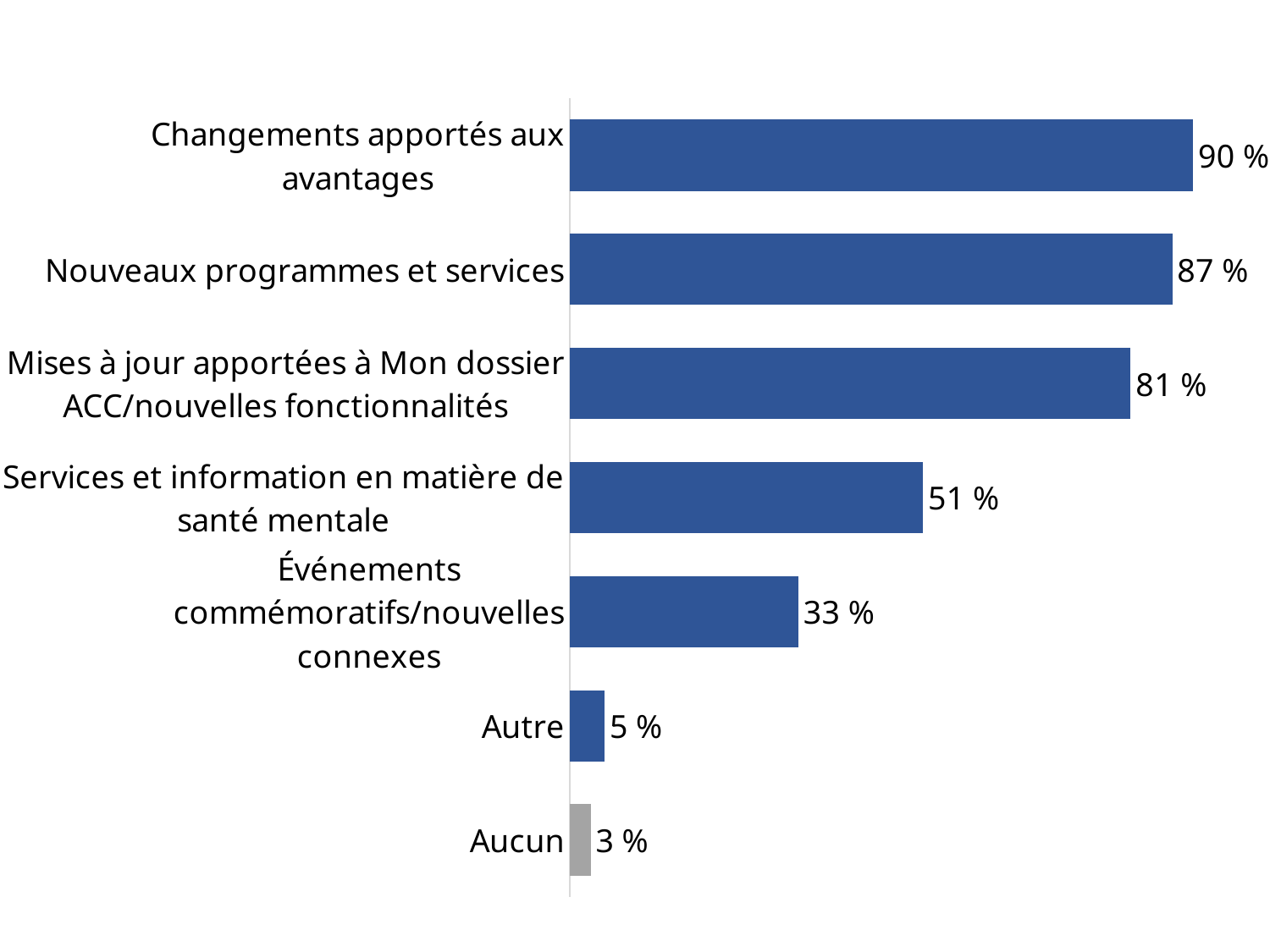
Which category has the highest value? Changements apportés aux avantages What is the value for "Services et information en matière de santé mentale"? 51 % Which bar is coloured grey instead of blue? Aucun How many categories are shown in the chart? 7 What is the difference between "Services et information en matière de santé mentale" and "Événements commémoratifs/nouvelles connexes"? 18 % What is the value for "Changements apportés aux avantages"? 90 % What is the value for "Aucun"? 3 % Which category has the lowest value? Aucun What kind of chart is this? Bar chart Which is larger, "Événements commémoratifs/nouvelles connexes" or "Services et information en matière de santé mentale"? Services et information en matière de santé mentale What is the difference between "Nouveaux programmes et services" and "Mises à jour apportées à Mon dossier ACC/nouvelles fonctionnalités"? 6 % Which is larger, "Autre" or "Aucun"? Autre